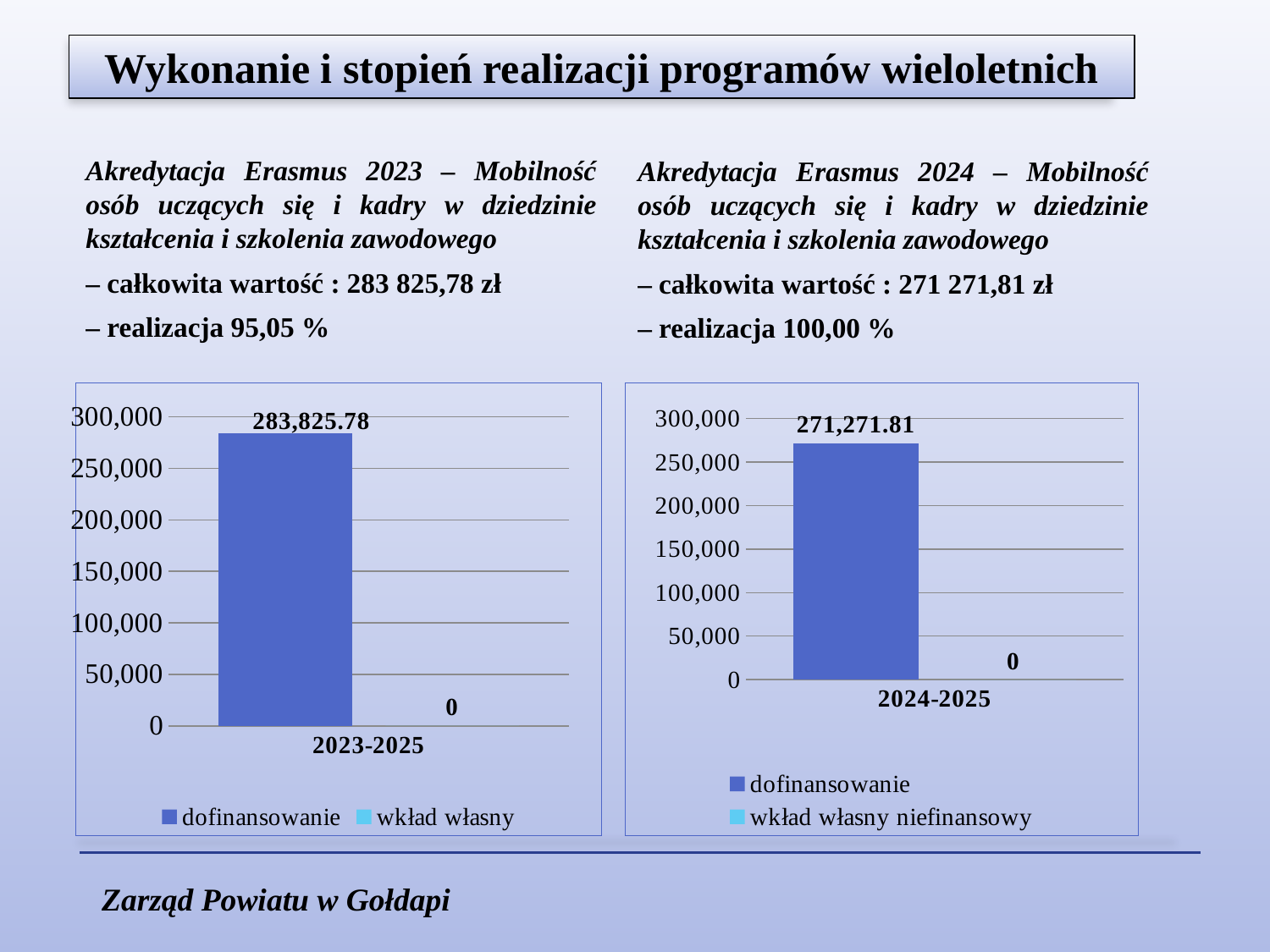
In the right chart, what is the value of dofinansowanie for 2024-2025? 271,271.81 In the right chart, what is the value of wkład własny niefinansowy for 2024-2025? 0 In the left chart, what is the value of wkład własny for 2023-2025? 0 How many series does the legend of the left chart list? 2 Which is larger: dofinansowanie in the left chart (2023-2025) or dofinansowanie in the right chart (2024-2025)? dofinansowanie in the left chart (2023-2025) In the right chart, is the value of dofinansowanie greater or less than 250,000? greater In the left chart, what is the difference between dofinansowanie and wkład własny for 2023-2025? 283,825.78 In the left chart, which series has the higher value for 2023-2025? dofinansowanie What category label appears on the x axis of the right chart? 2024-2025 In the left chart, what is the value of dofinansowanie for 2023-2025? 283,825.78 How many categories are shown on the x axis of the left chart? 1 What kind of chart is the right chart? bar chart